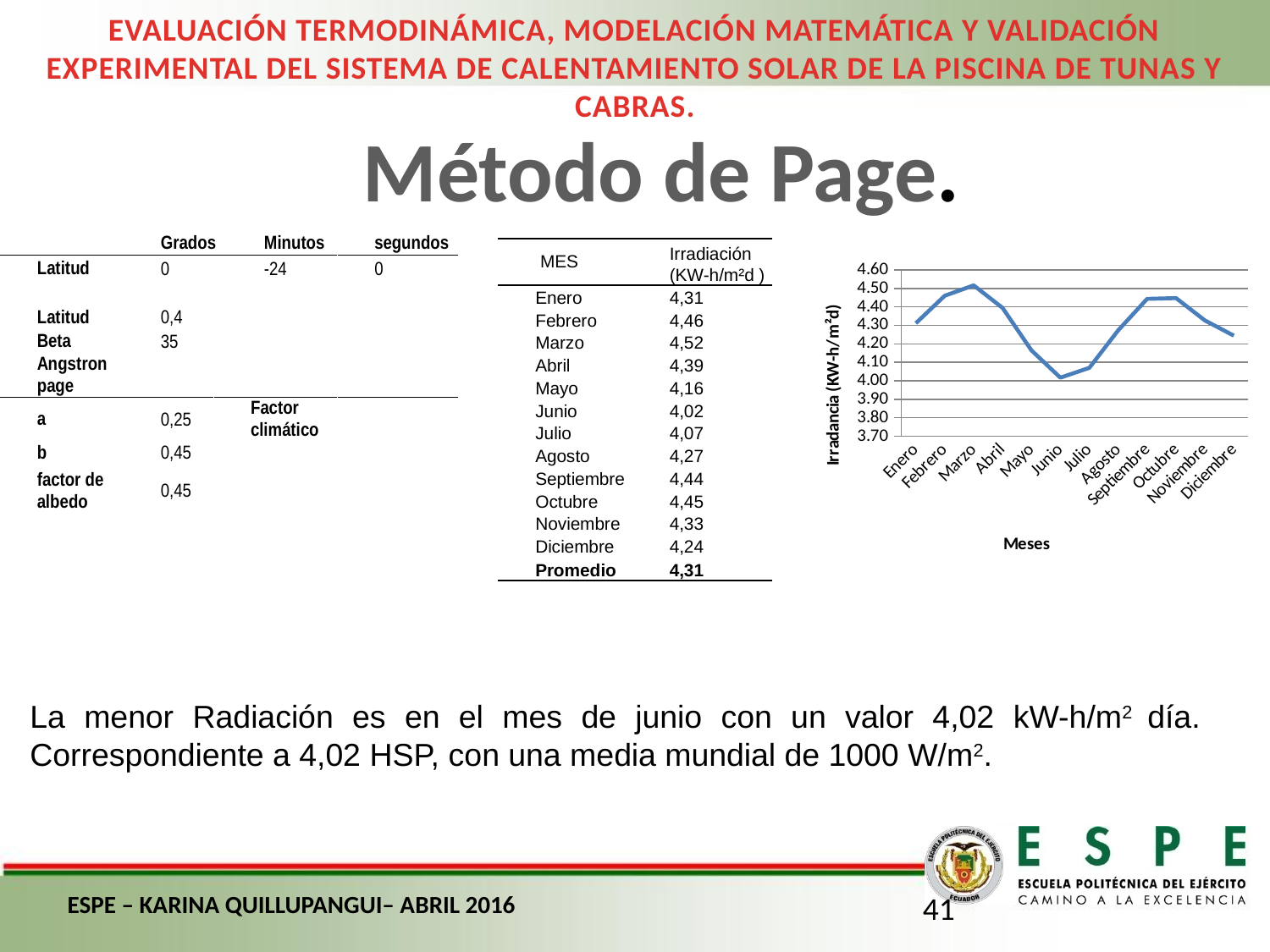
Do the values rise or fall from Junio to Octubre? rise Is the value for Enero greater or less than 4.20? greater Is the value for Octubre greater or less than 4.30? greater Which month has the lowest irradiance value in the chart? Junio What is the title of the x axis of the chart? Meses How many months are plotted along the x axis of the chart? 12 Do the values rise or fall from Marzo to Junio? fall Which is larger, the value for Marzo or the value for Junio? Marzo Is the value for Mayo greater or less than 4.30? less What kind of chart is shown on the slide? line chart Which month has the highest irradiance value in the chart? Marzo